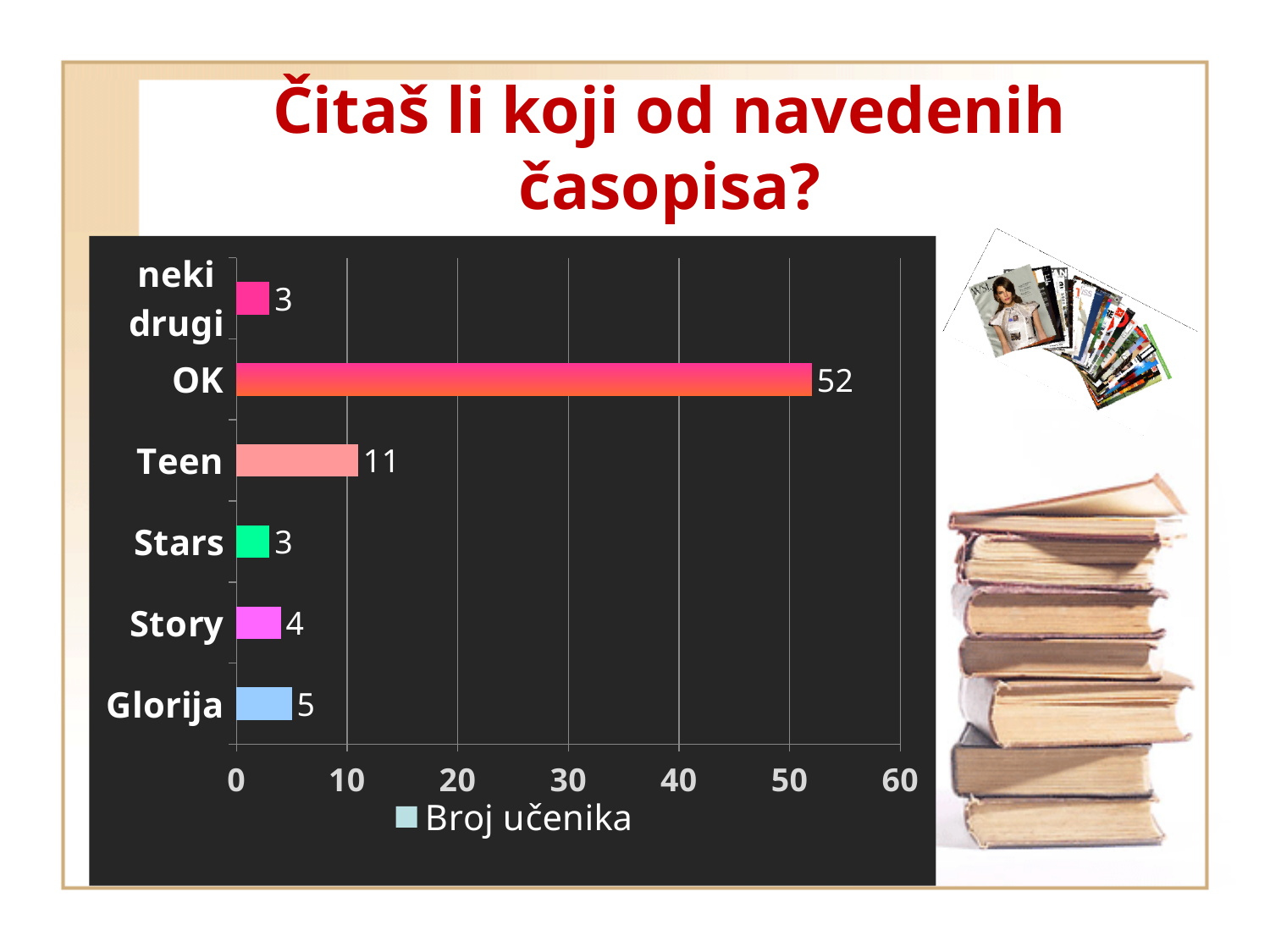
What is the value for Glorija? 5 Which is larger, the value for Glorija or the value for Story? Glorija What kind of chart is shown on the slide? bar chart Which category has the highest value? OK What is the name of the series in the legend? Broj učenika What is the value for Teen? 11 What is the value for Story? 4 How many categories are shown in the chart? 6 What is the value for OK? 52 How many series does the legend list? 1 What is the difference between the values for OK and Teen? 41 Is the value for OK greater or less than 50? greater